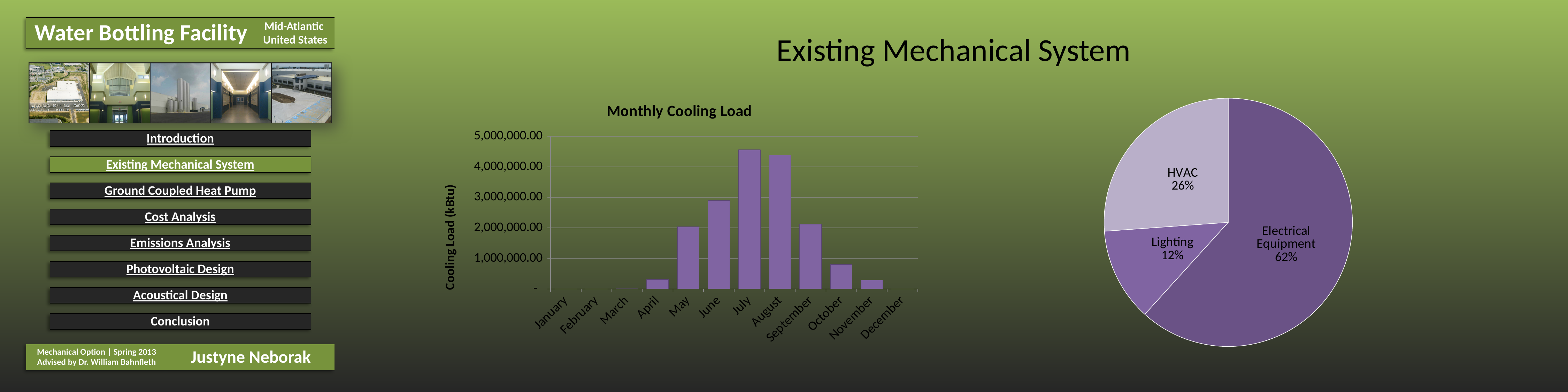
In the pie chart on the right, what is the difference between the Electrical Equipment share and the Lighting share? 50% What kind of chart is the Monthly Cooling Load chart? bar chart In the Monthly Cooling Load chart, is the value for June greater or less than 2,000,000.00? greater In the Monthly Cooling Load chart, is the value for July greater or less than 4,000,000.00? greater In the pie chart on the right, what share does HVAC have? 26% In the Monthly Cooling Load chart, which month has the highest cooling load? July In the Monthly Cooling Load chart, is the value for October greater or less than 1,000,000.00? less In the Monthly Cooling Load chart, do the values rise or fall from April to July? rise In the pie chart on the right, which category has the largest share? Electrical Equipment What is the y-axis label of the Monthly Cooling Load chart? Cooling Load (kBtu) In the Monthly Cooling Load chart, which is larger, the value for June or the value for September? June How many months are shown on the x axis of the Monthly Cooling Load chart? 12